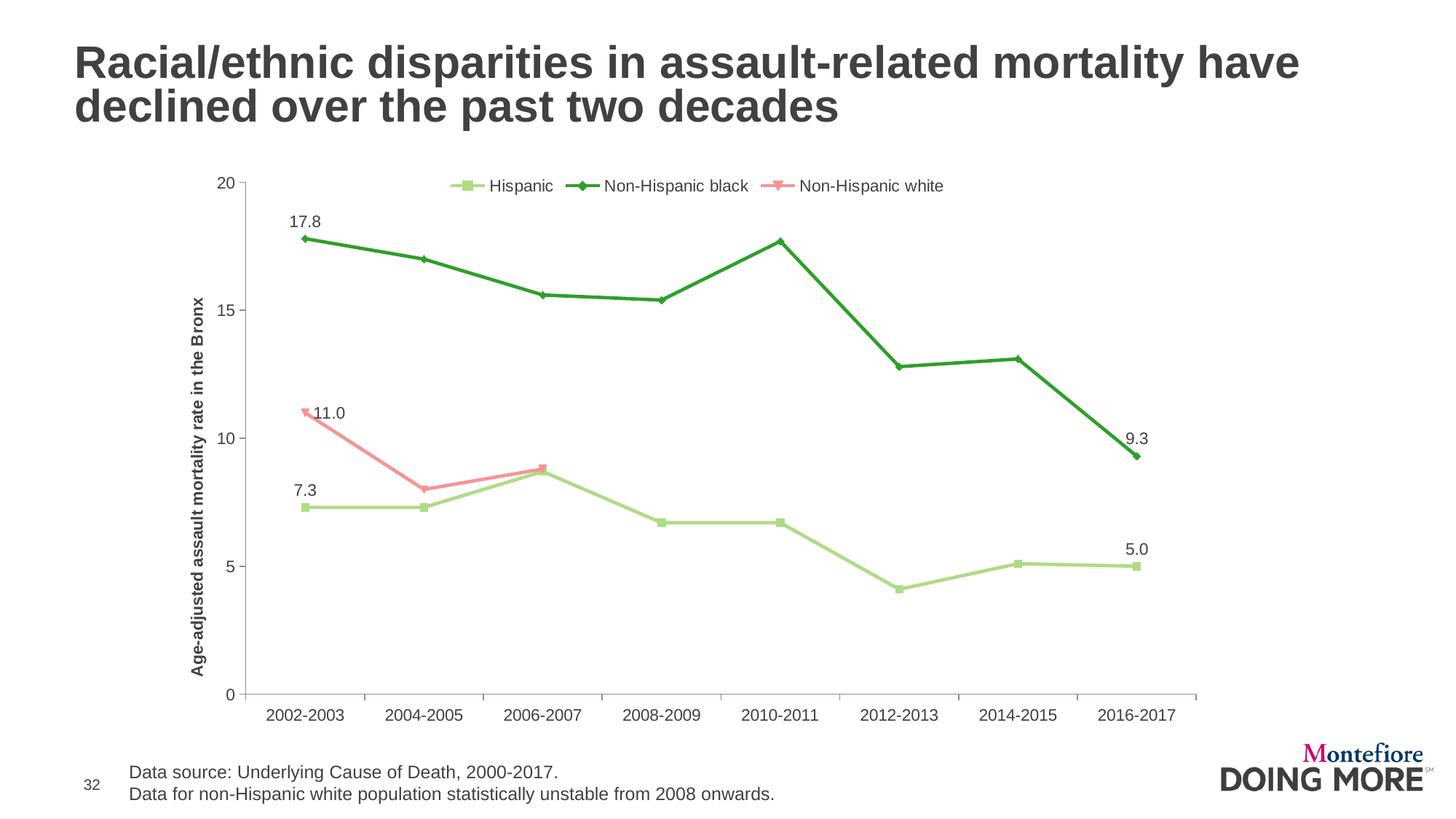
Which series has the lowest rate in 2016-2017? Hispanic What is the age-adjusted assault mortality rate for Non-Hispanic white in 2002-2003? 11.0 What is the difference between the Non-Hispanic black and Hispanic rates in 2002-2003? 10.5 What is the age-adjusted assault mortality rate for Non-Hispanic black in 2016-2017? 9.3 Which series has the highest rate in 2002-2003? Non-Hispanic black What kind of chart is shown on the slide? line chart What is the age-adjusted assault mortality rate for Non-Hispanic black in 2002-2003? 17.8 By how much did the Non-Hispanic black rate fall from 2002-2003 to 2016-2017? 8.5 What is the age-adjusted assault mortality rate for Hispanic in 2016-2017? 5.0 Does the Hispanic rate generally rise or fall from 2002-2003 to 2016-2017? fall How many series does the legend list? 3 Is the Non-Hispanic black rate in 2012-2013 greater or less than 15? less